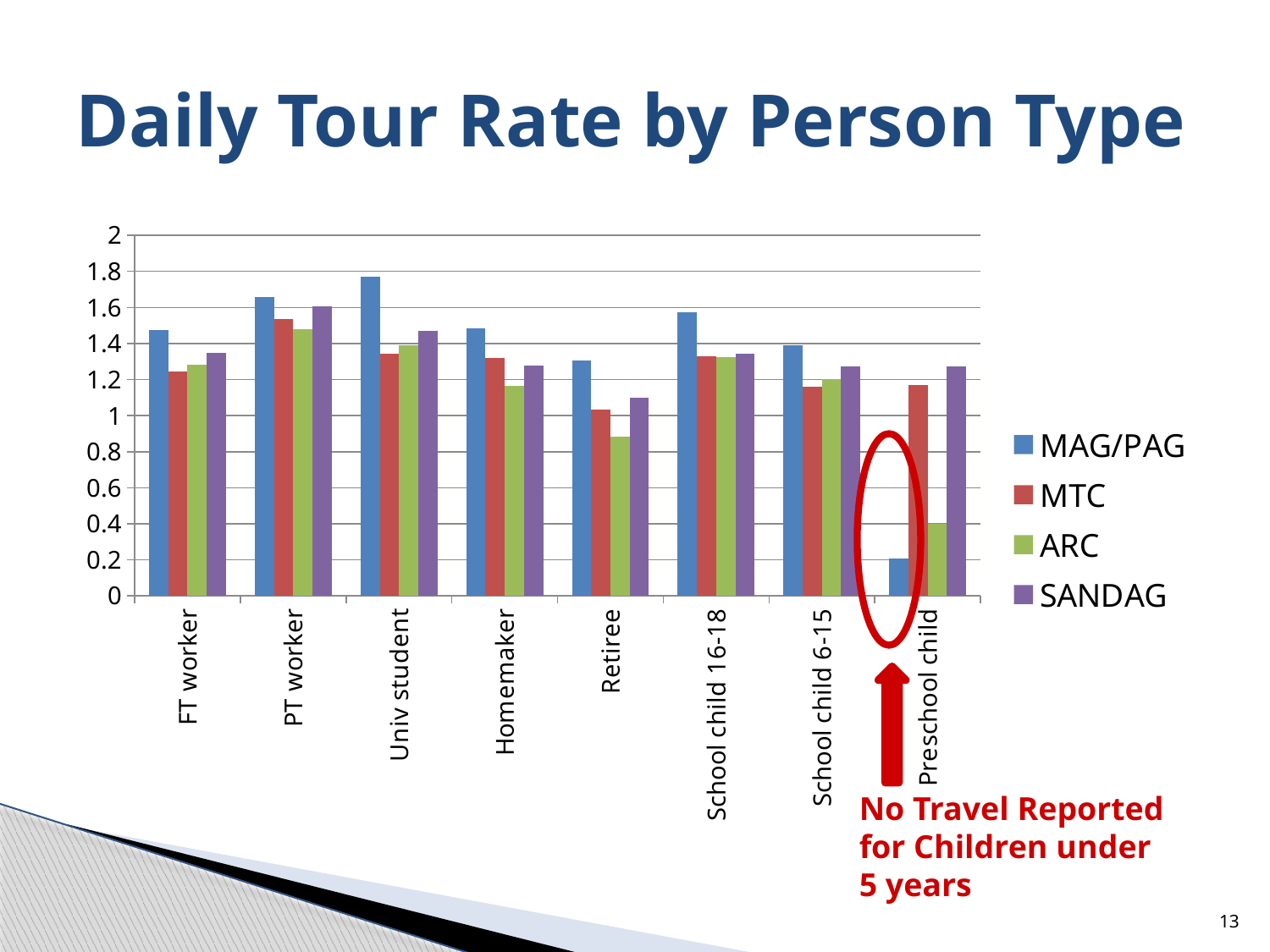
How many series does the legend list? 4 How many person type categories are shown on the x axis? 8 Is the ARC value for Retiree greater or less than 1? less Which person type has the highest MAG/PAG daily tour rate? Univ student For Preschool child, which is larger: the MTC value or the ARC value? MTC Is the MAG/PAG value for Univ student greater or less than 1.6? greater Which person type has the lowest ARC daily tour rate? Preschool child Is the MAG/PAG value for Preschool child greater or less than 0.4? less What is the title of the slide? Daily Tour Rate by Person Type For Retiree, which is larger: the MAG/PAG value or the MTC value? MAG/PAG What kind of chart is shown on the slide? Bar chart Which person type has the lowest MAG/PAG daily tour rate? Preschool child